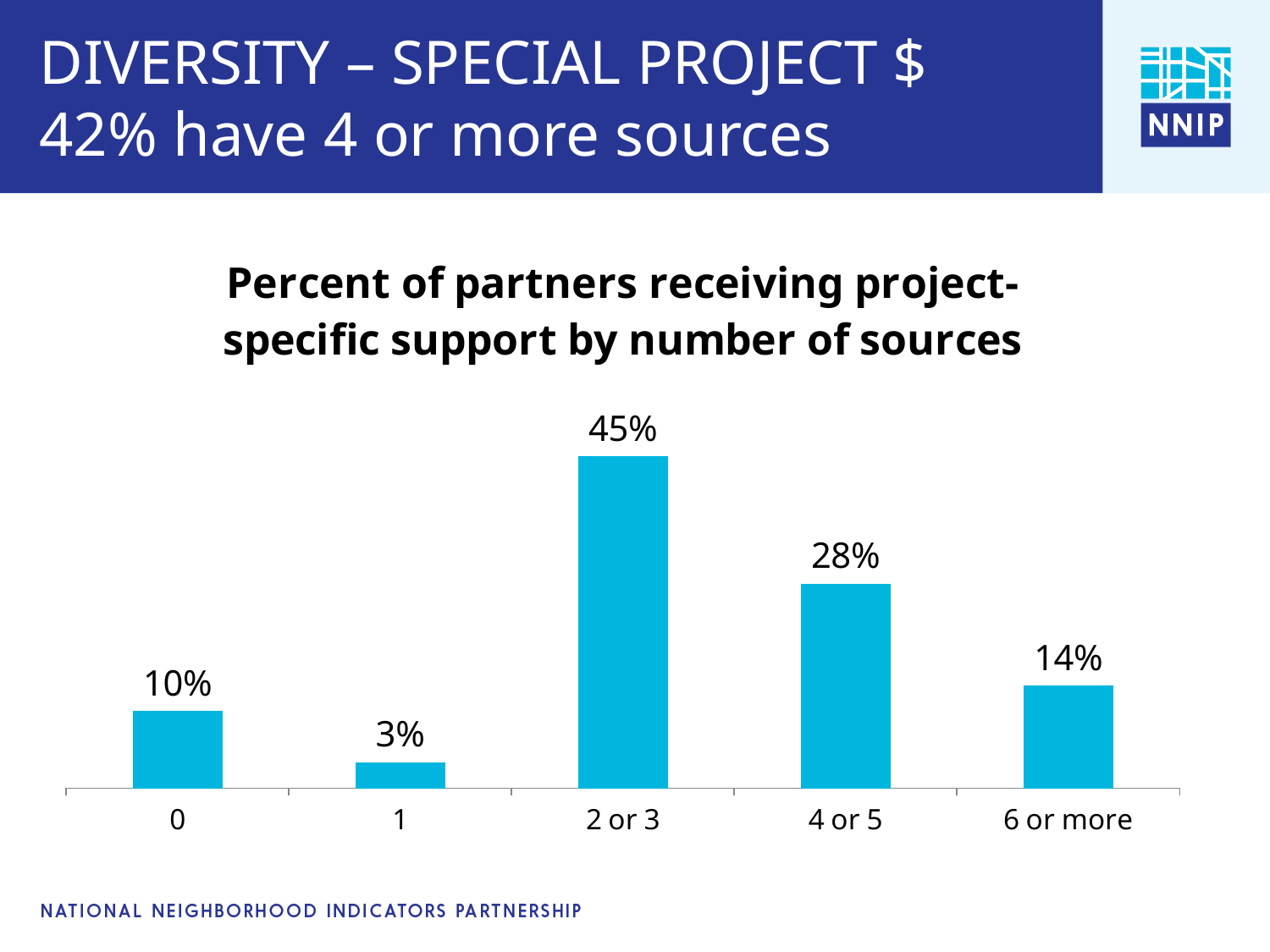
Which number-of-sources category has the highest percent of partners? 2 or 3 What is the combined value for the '4 or 5' and '6 or more' categories? 42% How many categories are shown on the x axis of the chart? 5 What percent of partners have 6 or more sources of project-specific support? 14% Which is larger, the value for '4 or 5' sources or the value for '6 or more' sources? 4 or 5 What is the value for the '0' sources category? 10% What is the difference between the values for '2 or 3' and '4 or 5' sources? 17% Which number-of-sources category has the lowest percent of partners? 1 What kind of chart is shown on the slide? Bar chart What is the difference between the values for '0' sources and '1' source? 7% What percent of partners receive project-specific support from 2 or 3 sources? 45% What is the title of the chart? Percent of partners receiving project-specific support by number of sources